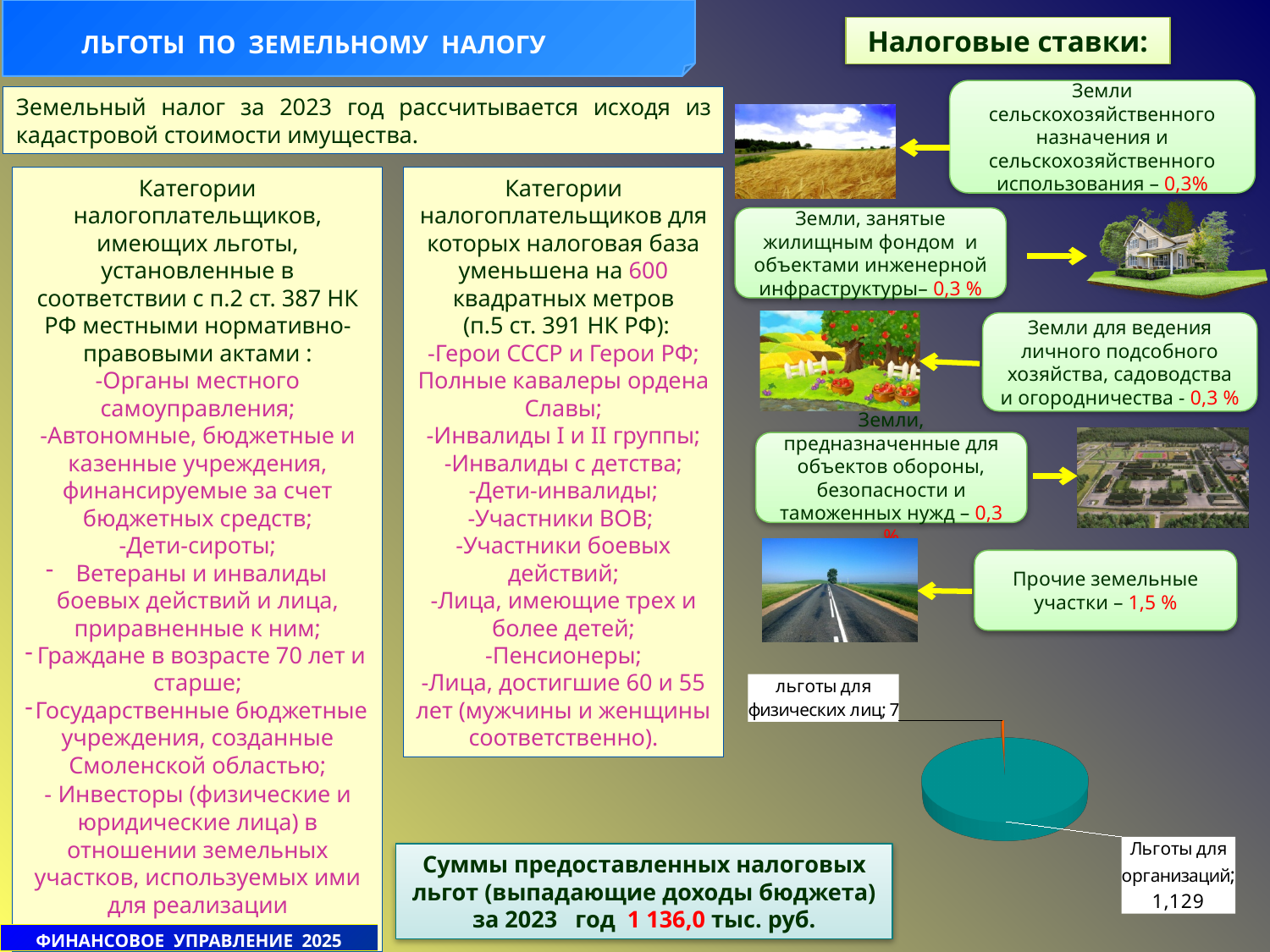
What kind of chart is shown at the bottom right of the slide? pie chart How many categories (slices) does the pie chart show? 2 Which slice of the pie chart takes up almost the entire pie? Льготы для организаций What is the total of the two values shown in the pie chart? 1,136 In the pie chart, which is larger: the value for "Льготы для организаций" or for "льготы для физических лиц"? Льготы для организаций In the pie chart, what is the value for "льготы для физических лиц"? 7 Which category in the pie chart has the smallest value? льготы для физических лиц Which category in the pie chart has the largest value? Льготы для организаций In the pie chart, what is the value for "Льготы для организаций"? 1,129 In the pie chart, what is the difference between the value for "Льготы для организаций" and the value for "льготы для физических лиц"? 1,122